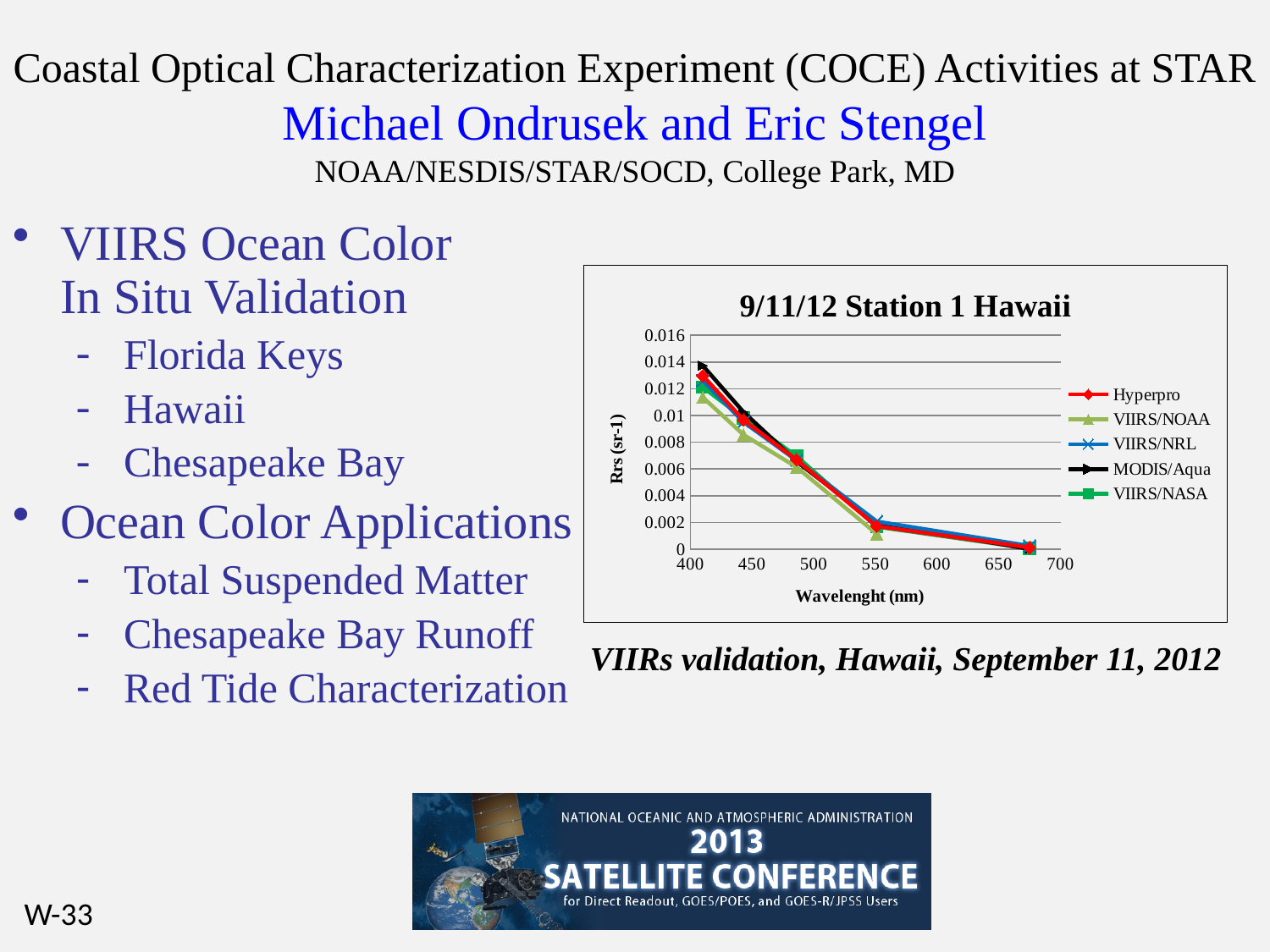
What kind of chart is shown on the slide? line chart How many data points are plotted for the Hyperpro series? 5 Do the Rrs values rise or fall as wavelength increases along the x axis? fall At the shortest wavelength (around 410 nm), which is larger: the MODIS/Aqua value or the VIIRS/NOAA value? MODIS/Aqua At the shortest wavelength (around 410 nm), which series has the lowest Rrs value? VIIRS/NOAA Is the MODIS/Aqua value at the shortest wavelength (around 410 nm) greater or less than 0.012? greater How many series does the chart legend list? 5 What is the title of the chart? 9/11/12 Station 1 Hawaii Is the Hyperpro value at around 550 nm greater or less than 0.004? less What is the label of the chart's x axis? Wavelenght (nm) Is the VIIRS/NRL value at around 490 nm greater or less than 0.008? less